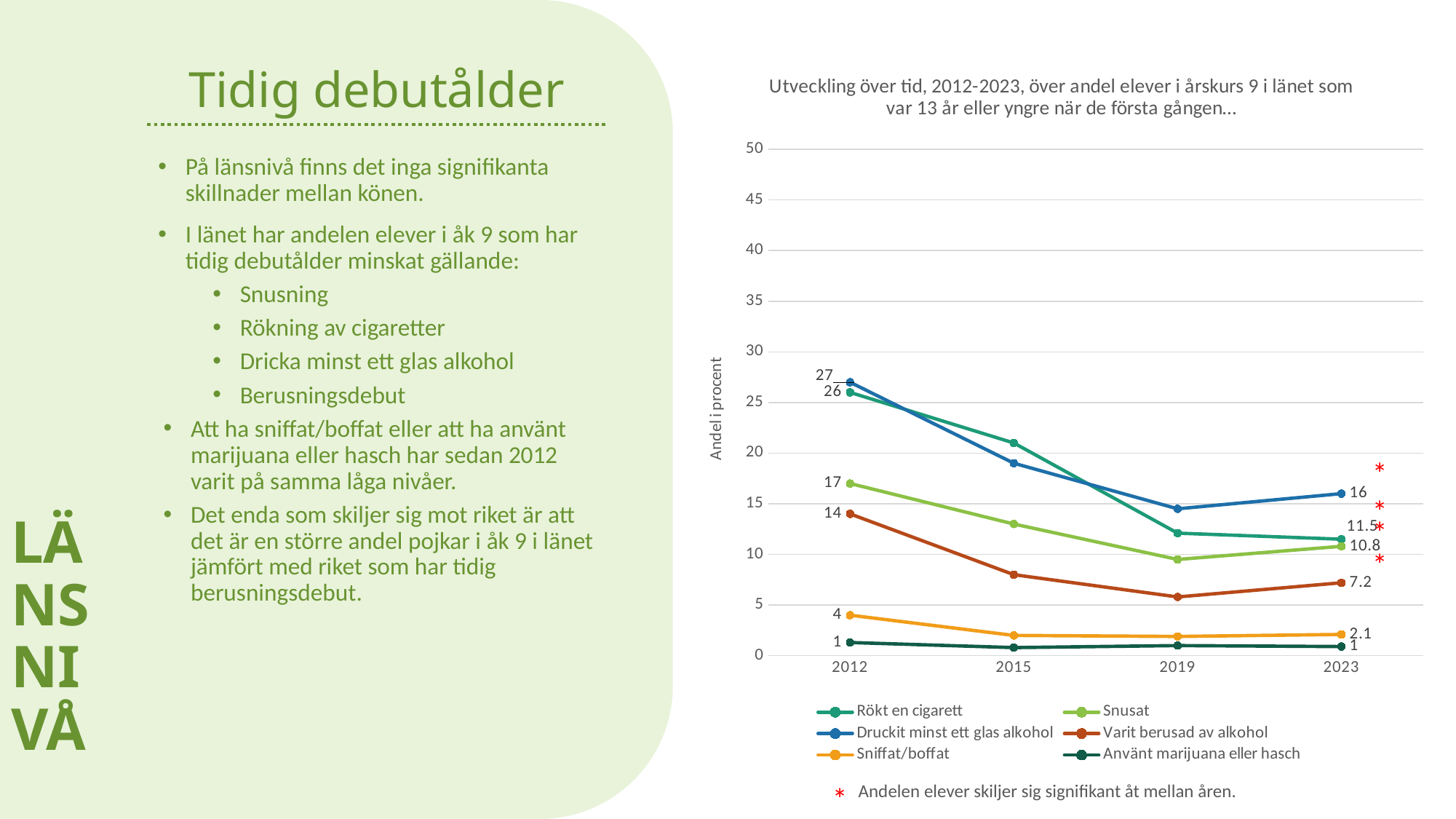
In 2023, which is larger: Sniffat/boffat or Använt marijuana eller hasch? Sniffat/boffat What is the value for Druckit minst ett glas alkohol in 2012? 27 Is the value for Rökt en cigarett in 2015 greater or less than 20? greater Which series has the highest value in 2012? Druckit minst ett glas alkohol How many series does the legend list? 6 What is the value for Varit berusad av alkohol in 2023? 7.2 By how much did the value for Snusat decrease from 2012 to 2023? 6.2 What is the value for Rökt en cigarett in 2023? 11.5 What is the difference between the 2012 and 2023 values for Druckit minst ett glas alkohol? 11 What kind of chart is shown on the slide? line chart Which series has the lowest value in 2023? Använt marijuana eller hasch What is the value for Snusat in 2012? 17